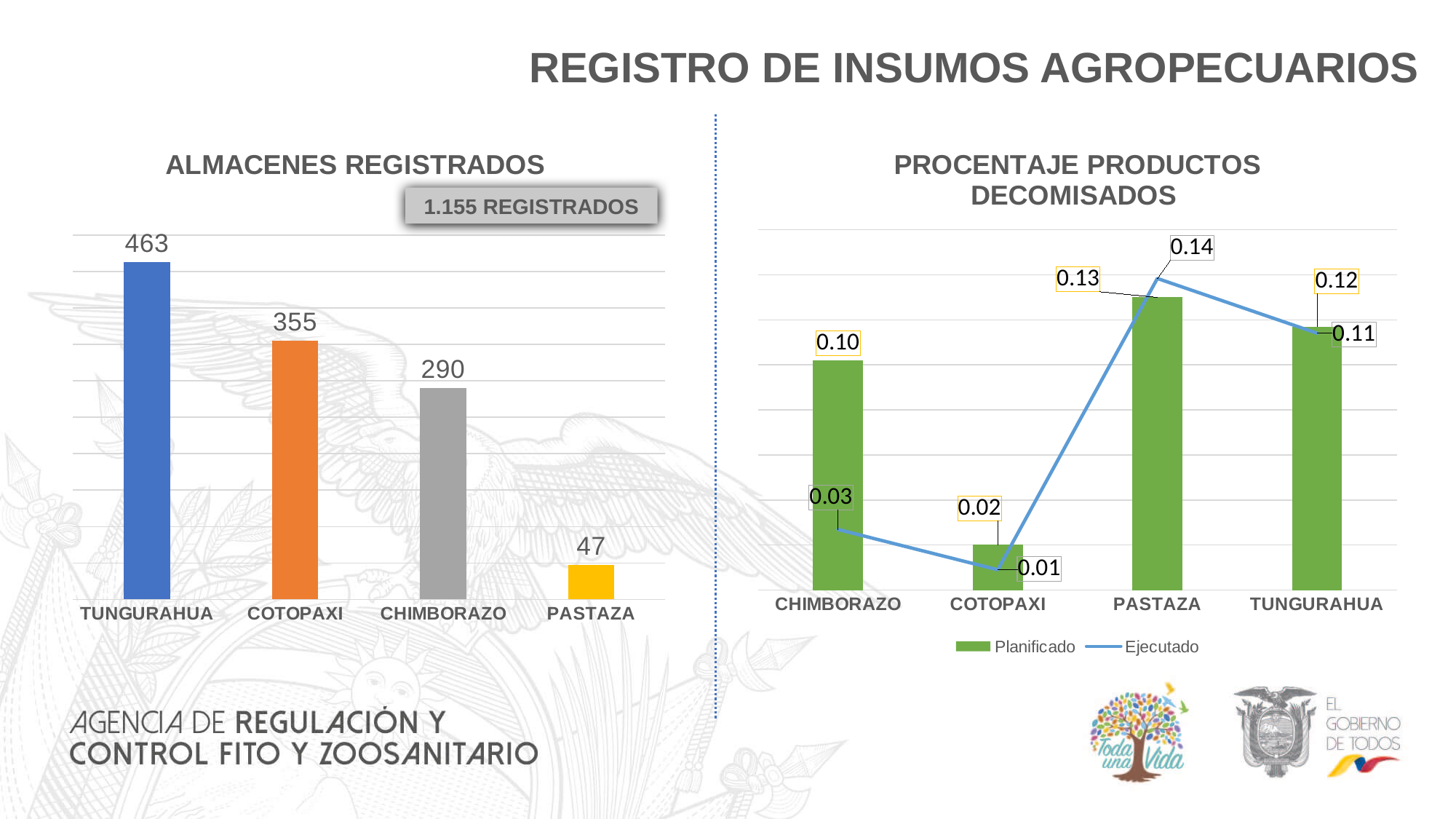
In the PROCENTAJE PRODUCTOS DECOMISADOS chart, what is the Planificado value for CHIMBORAZO? 0.10 In the ALMACENES REGISTRADOS chart, what is the value for COTOPAXI? 355 In the PROCENTAJE PRODUCTOS DECOMISADOS chart, how many series does the legend list? 2 In the PROCENTAJE PRODUCTOS DECOMISADOS chart, is the Planificado value for TUNGURAHUA larger or smaller than its Ejecutado value? larger In the PROCENTAJE PRODUCTOS DECOMISADOS chart, what is the Ejecutado value for PASTAZA? 0.14 In the ALMACENES REGISTRADOS chart, how many provinces are shown? 4 In the ALMACENES REGISTRADOS chart, what is the difference between TUNGURAHUA and CHIMBORAZO? 173 In the ALMACENES REGISTRADOS chart, which province has the lowest value? PASTAZA In the PROCENTAJE PRODUCTOS DECOMISADOS chart, which province has the lowest Ejecutado value? COTOPAXI In the PROCENTAJE PRODUCTOS DECOMISADOS chart, which series is drawn as a line? Ejecutado In the ALMACENES REGISTRADOS chart, do the values rise or fall from left to right? fall In the ALMACENES REGISTRADOS chart, which province has the highest value? TUNGURAHUA